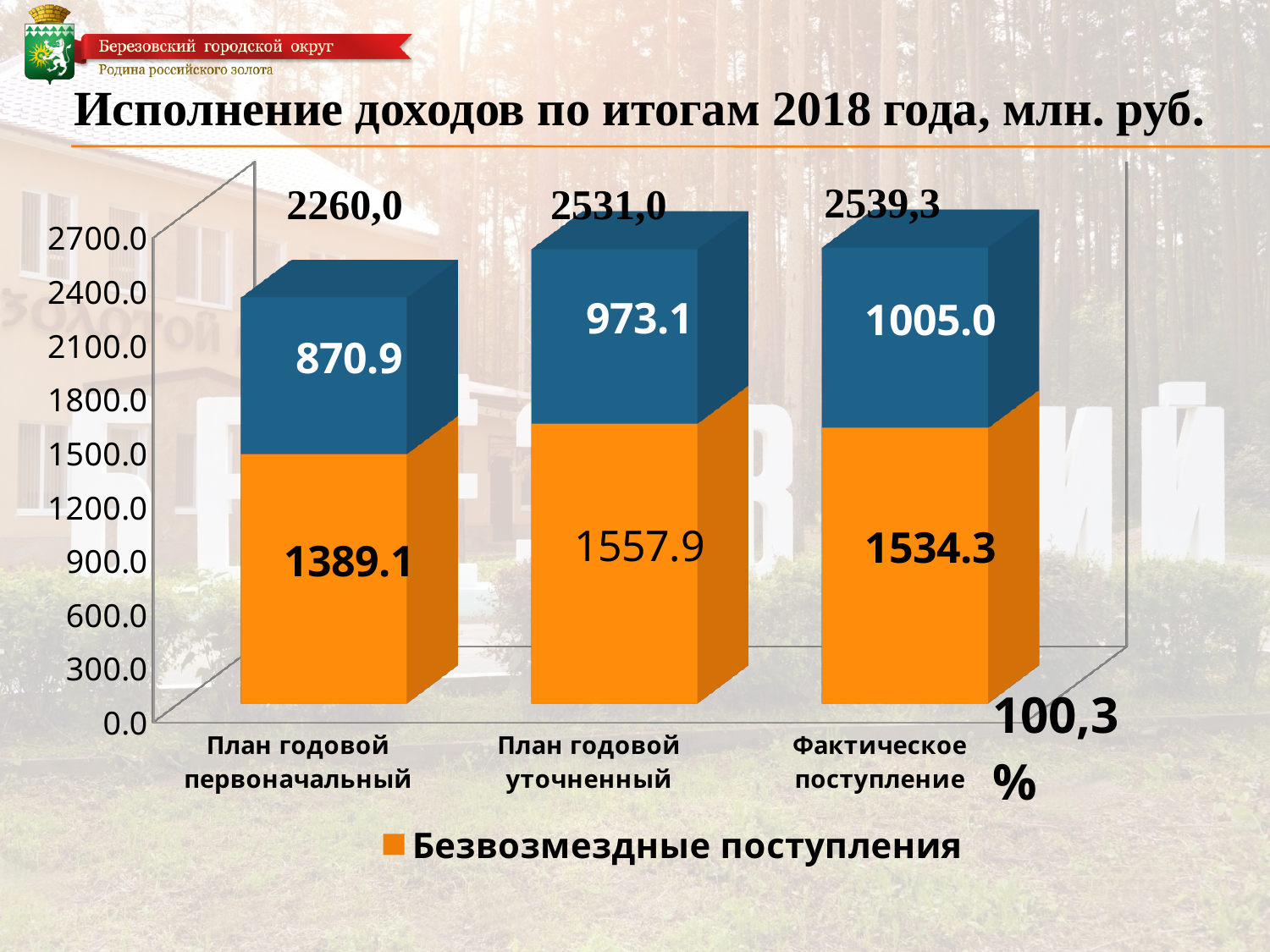
How many categories are shown on the x axis of the chart? 3 What is the value of Безвозмездные поступления for План годовой первоначальный? 1389.1 Which category has the lowest value for the blue segment? План годовой первоначальный What is the title of the chart? Исполнение доходов по итогам 2018 года, млн. руб. What is the difference between the blue segment values for Фактическое поступление and План годовой первоначальный? 134.1 Which is larger: Безвозмездные поступления for План годовой уточненный or for Фактическое поступление? План годовой уточненный What is the total printed above the bar for План годовой первоначальный? 2260,0 What is the value of the blue segment for Фактическое поступление? 1005.0 What is the value of Безвозмездные поступления for План годовой уточненный? 1557.9 What is the total printed above the bar for Фактическое поступление? 2539,3 What type of chart is shown on the slide? stacked bar chart Which category has the highest value of Безвозмездные поступления? План годовой уточненный